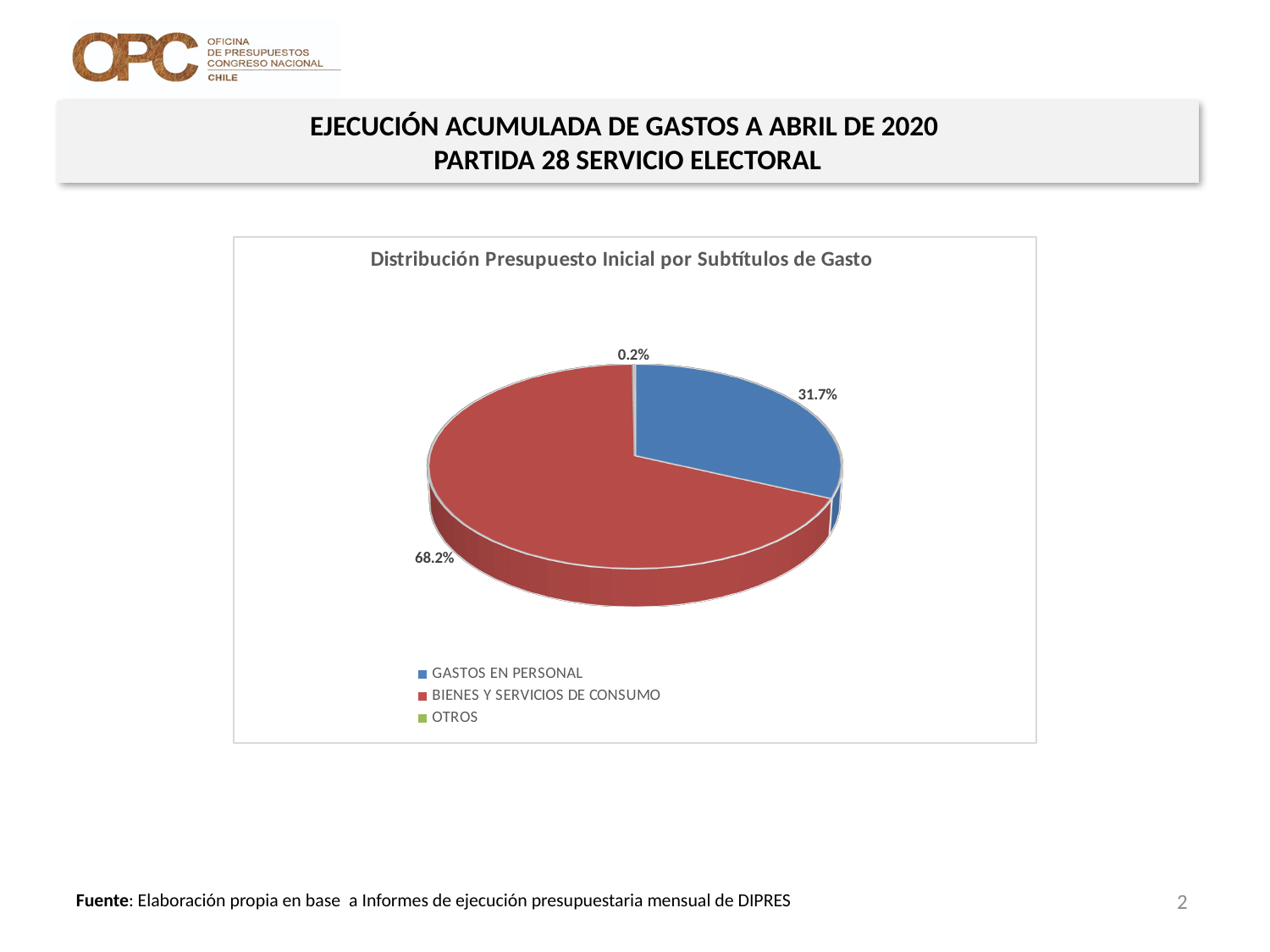
What share of the pie does GASTOS EN PERSONAL represent? 31.7% Which is larger, the share for GASTOS EN PERSONAL or the share for OTROS? GASTOS EN PERSONAL How many categories does the legend list? 3 Which category has the largest share of the pie? BIENES Y SERVICIOS DE CONSUMO Which category has the smallest share of the pie? OTROS What share of the pie does BIENES Y SERVICIOS DE CONSUMO represent? 68.2% What is the difference in percentage points between BIENES Y SERVICIOS DE CONSUMO and GASTOS EN PERSONAL? 36.5 What share of the pie does OTROS represent? 0.2% What colour is the slice for GASTOS EN PERSONAL? Blue What type of chart is shown on the slide? Pie chart What is the title of the chart? Distribución Presupuesto Inicial por Subtítulos de Gasto